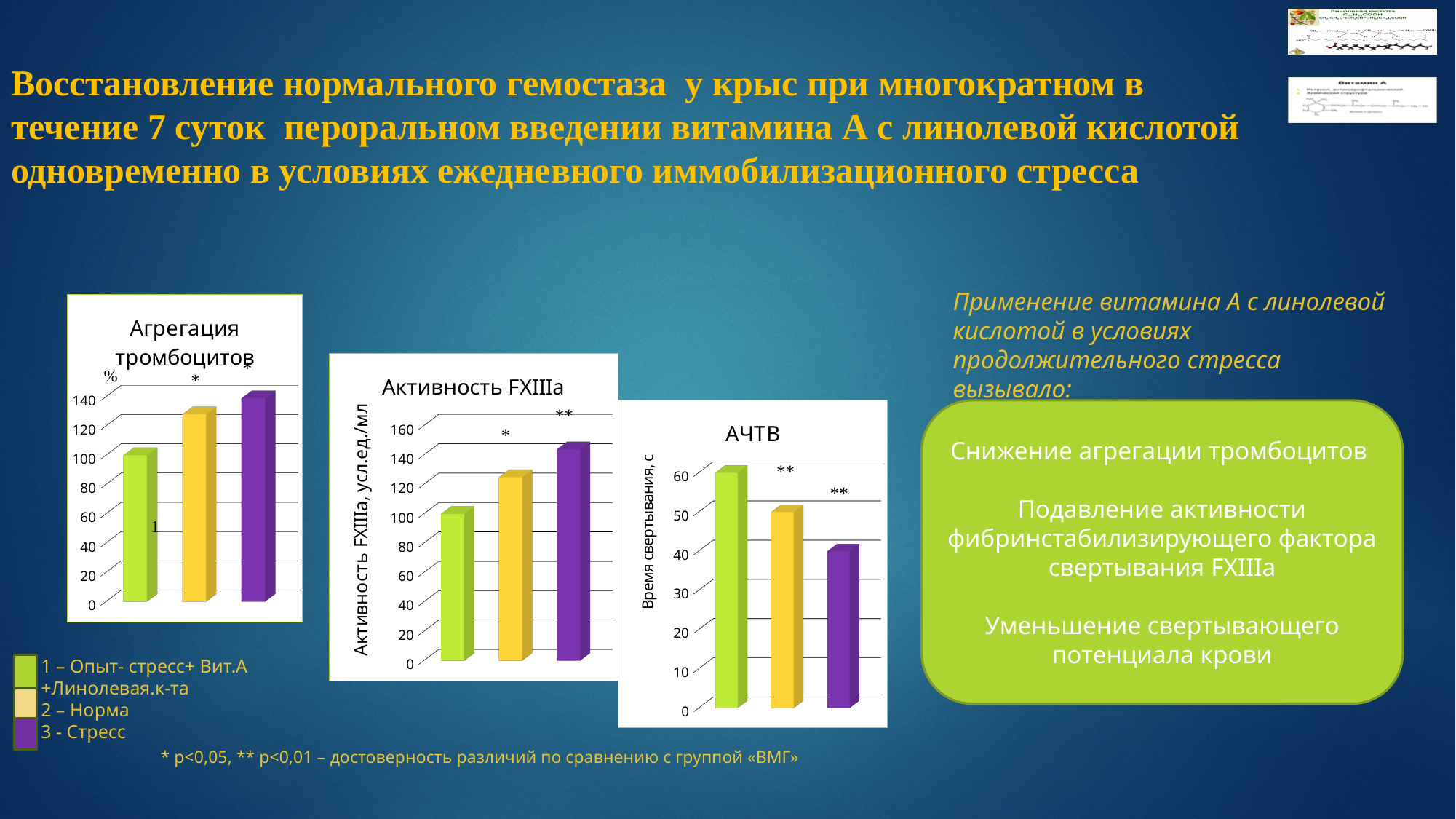
What kind of chart is the "Агрегация тромбоцитов" chart? bar chart In the "Агрегация тромбоцитов" chart, is the value for group 1 (Опыт) greater or less than 120? less In the "Активность FXIIIa" chart, is the value for group 3 (Стресс) greater or less than 120? greater In the "АЧТВ" chart, which group has the highest bar? 1 – Опыт- стресс+ Вит.А +Линолевая.к-та In the "Активность FXIIIa" chart, which is larger: the bar for Норма or the bar for Опыт? Норма In the "АЧТВ" chart, is the value for group 3 (Стресс) greater or less than 50? less In the "АЧТВ" chart, do the bars rise or fall from group 1 to group 3? fall In the "АЧТВ" chart, how many bars are plotted? 3 According to the legend, which group is represented by the yellow bars? 2 - Норма What is the y-axis label of the "Активность FXIIIa" chart? Активность FXIIIa, усл.ед./мл In the "Агрегация тромбоцитов" chart, which group has the highest bar? 3 - Стресс In the "АЧТВ" chart, which group has the lowest bar? 3 - Стресс